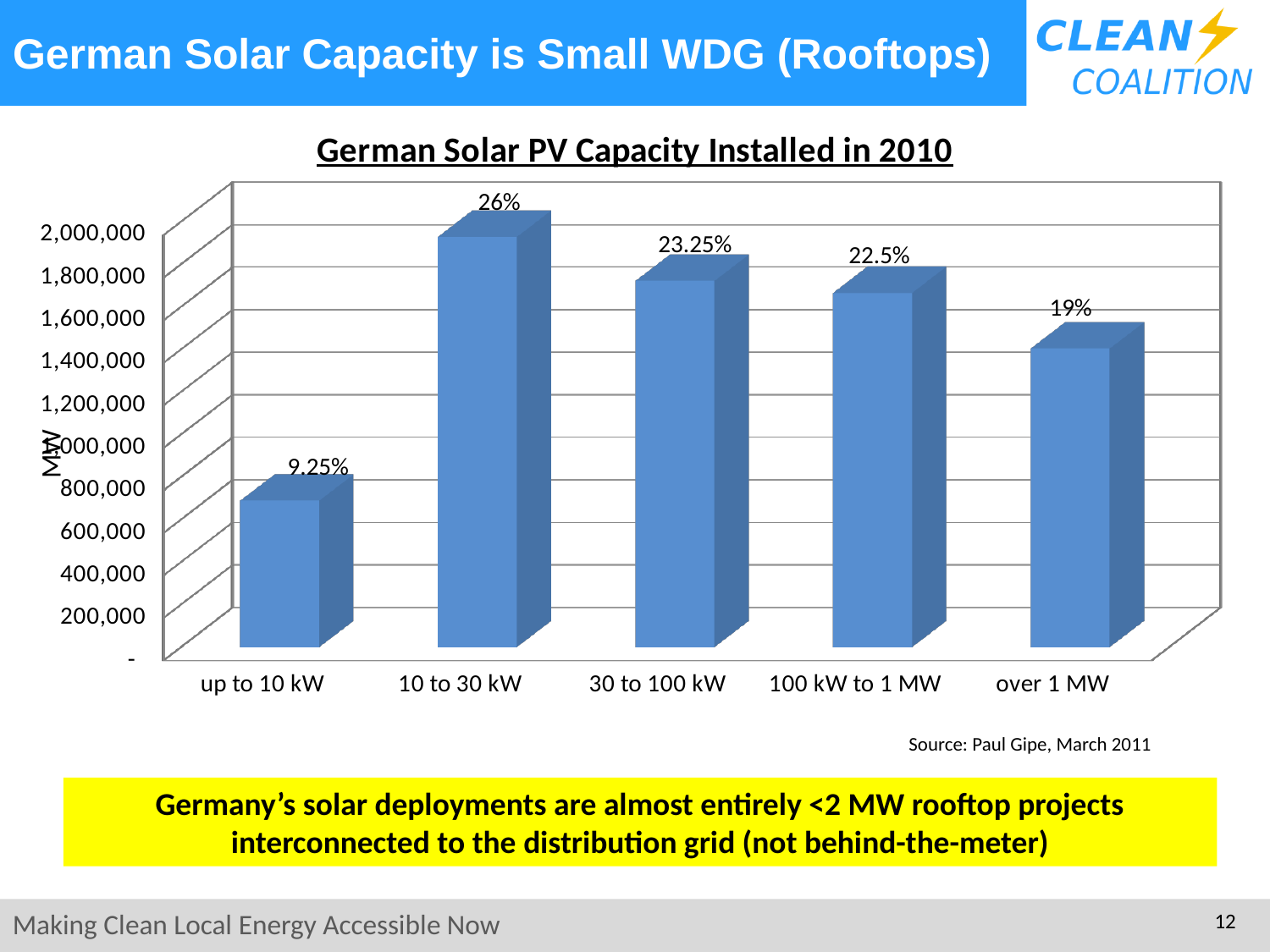
What percentage label is shown on the bar for 'up to 10 kW'? 9.25% What percentage label is shown on the bar for '10 to 30 kW'? 26% What is the title of the chart? German Solar PV Capacity Installed in 2010 How many categories are shown on the x axis of the chart? 5 Which category has the lowest installed capacity? up to 10 kW What percentage label is shown on the bar for 'over 1 MW'? 19% Which has the larger installed capacity, '30 to 100 kW' or 'over 1 MW'? 30 to 100 kW Which category has the highest installed capacity? 10 to 30 kW Is the value for 'up to 10 kW' greater or less than 800,000? less What percentage label is shown on the bar for '100 kW to 1 MW'? 22.5% What is the difference in percentage points between the labels for '10 to 30 kW' (26%) and 'up to 10 kW' (9.25%)? 16.75 percentage points What kind of chart is shown on the slide? bar chart